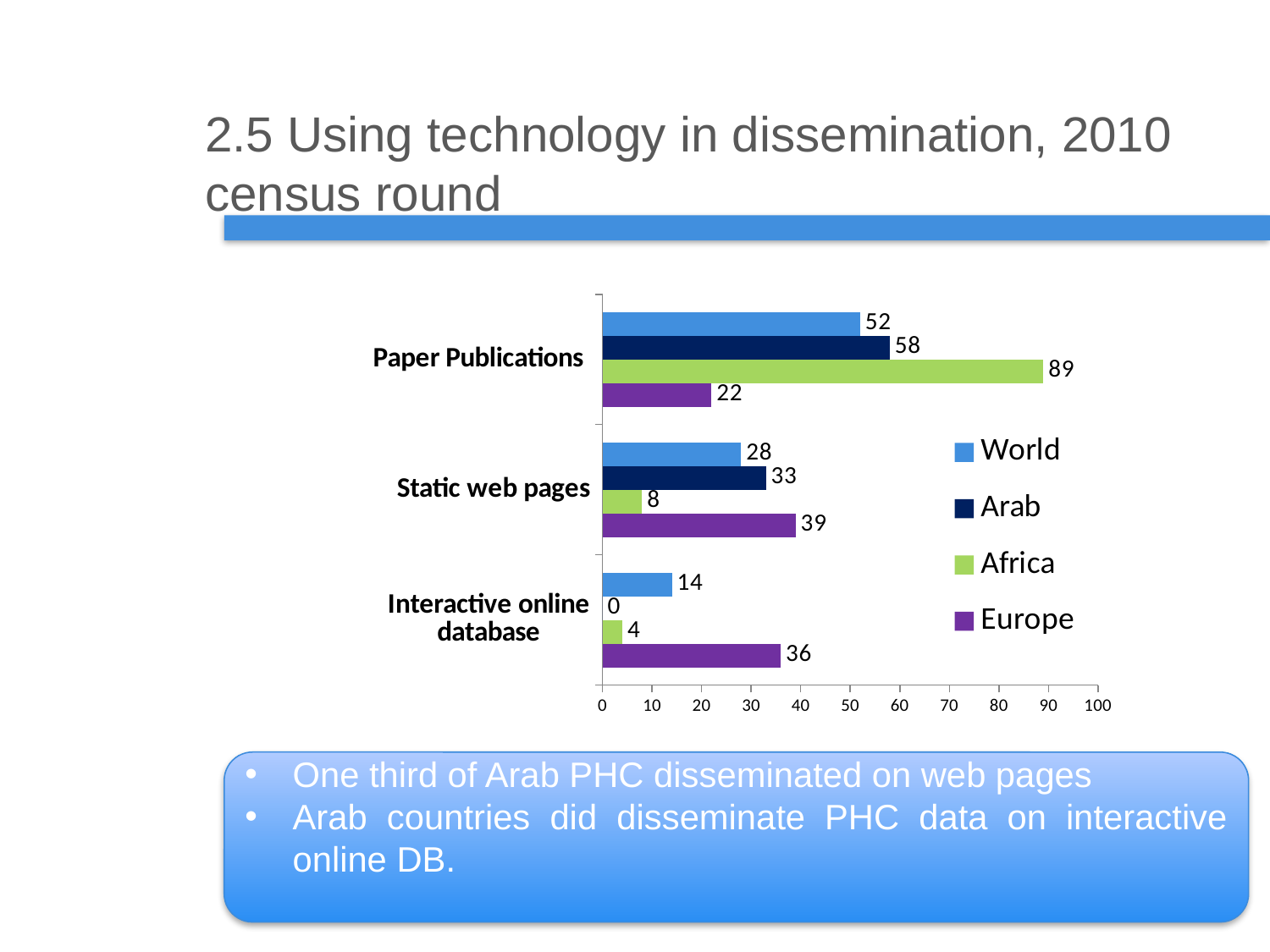
Which series has the lowest value in the Static web pages category? Africa What is the value for Europe in the Static web pages category? 39 What is the value for Arab in the Interactive online database category? 0 What is the difference between the Europe and Africa values for Interactive online database? 32 Which colour represents the Europe series in the chart? purple Which series has the highest value in the Paper Publications category? Africa Which is larger for Static web pages, the World value or the Arab value? Arab What is the difference between the Arab and World values for Paper Publications? 6 What is the value for Africa in the Paper Publications category? 89 How many series does the legend list? 4 What kind of chart is shown on the slide? bar chart How many categories are shown on the chart? 3